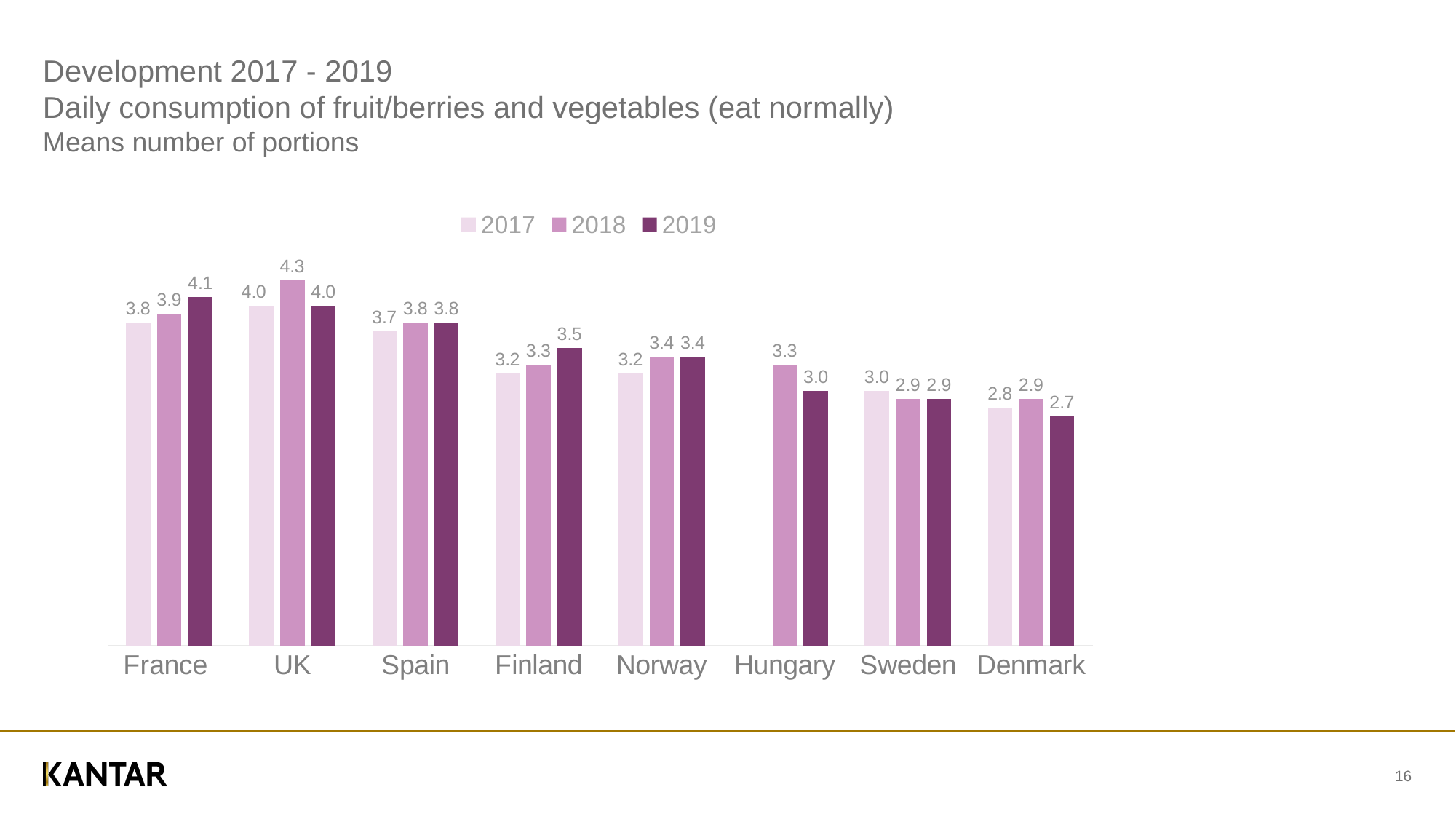
Which country has the lowest value in 2019? Denmark How many countries are shown on the x axis? 8 What is the value for Hungary in 2019? 3.0 What is the value for France in 2019? 4.1 What kind of chart is shown on the slide? Bar chart What is the value for the UK in 2018? 4.3 Which country has no bar for 2017? Hungary Which is larger, the 2019 value for Finland or the 2019 value for Norway? Finland Which country has the highest value in 2018? UK How many series does the legend list? 3 Do the values for France rise or fall from 2017 to 2019? Rise What is the difference between the UK's 2018 value and its 2019 value? 0.3